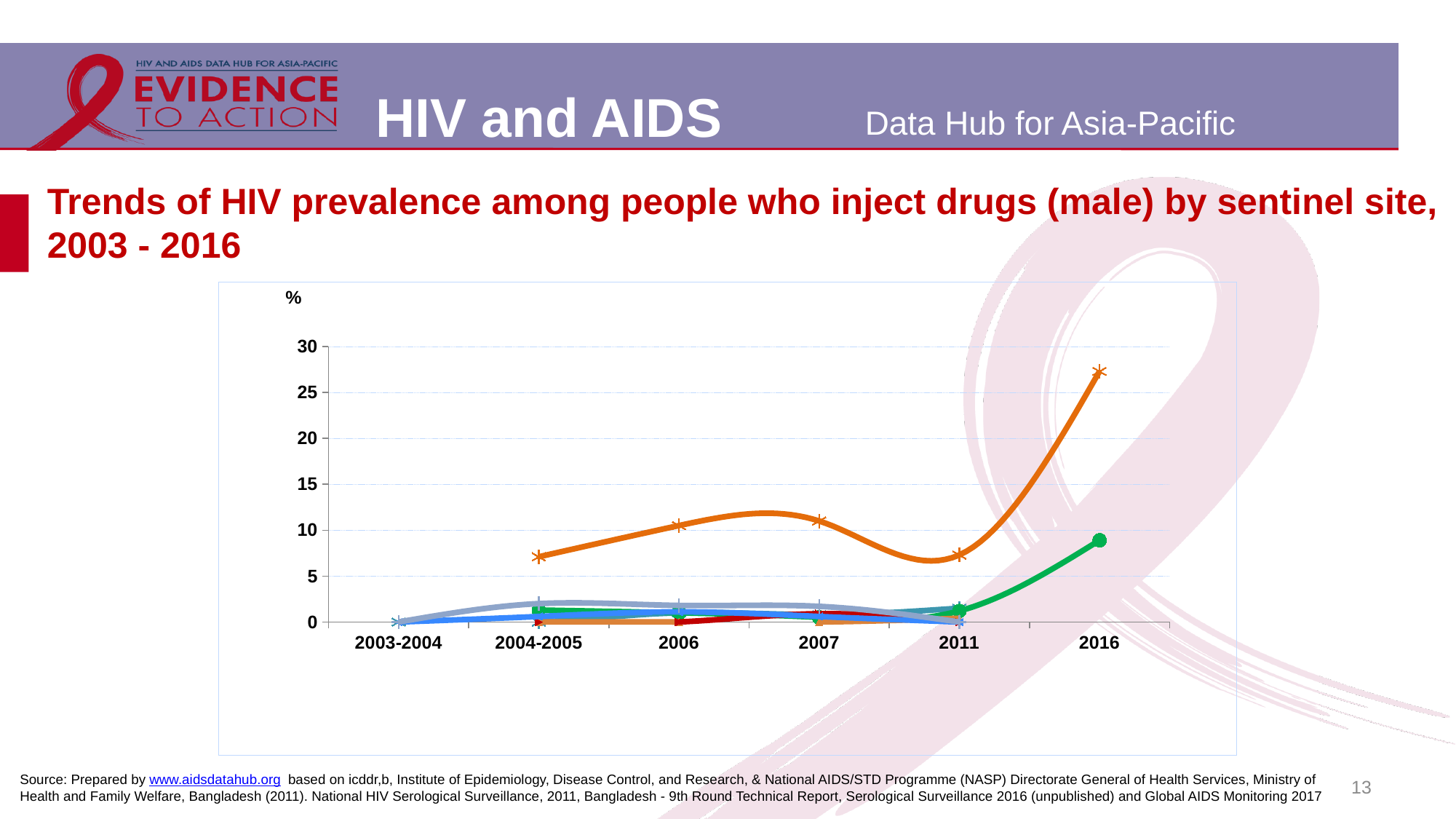
What unit is shown at the top of the y axis of the chart? % In 2016, which line has the larger value, the orange line or the green line? orange line In which period does the orange line reach its highest value? 2016 What is the title of the chart on the slide? Trends of HIV prevalence among people who inject drugs (male) by sentinel site, 2003 - 2016 Is the value of the green line in 2016 greater or less than 5? greater How many time periods are labelled on the x axis of the chart? 6 Is the value of the orange line in 2004-2005 greater or less than 5? greater Is the value of the green line in 2016 greater or less than 10? less Does the green line rise or fall between 2011 and 2016? rise What kind of chart is shown on the slide? line chart